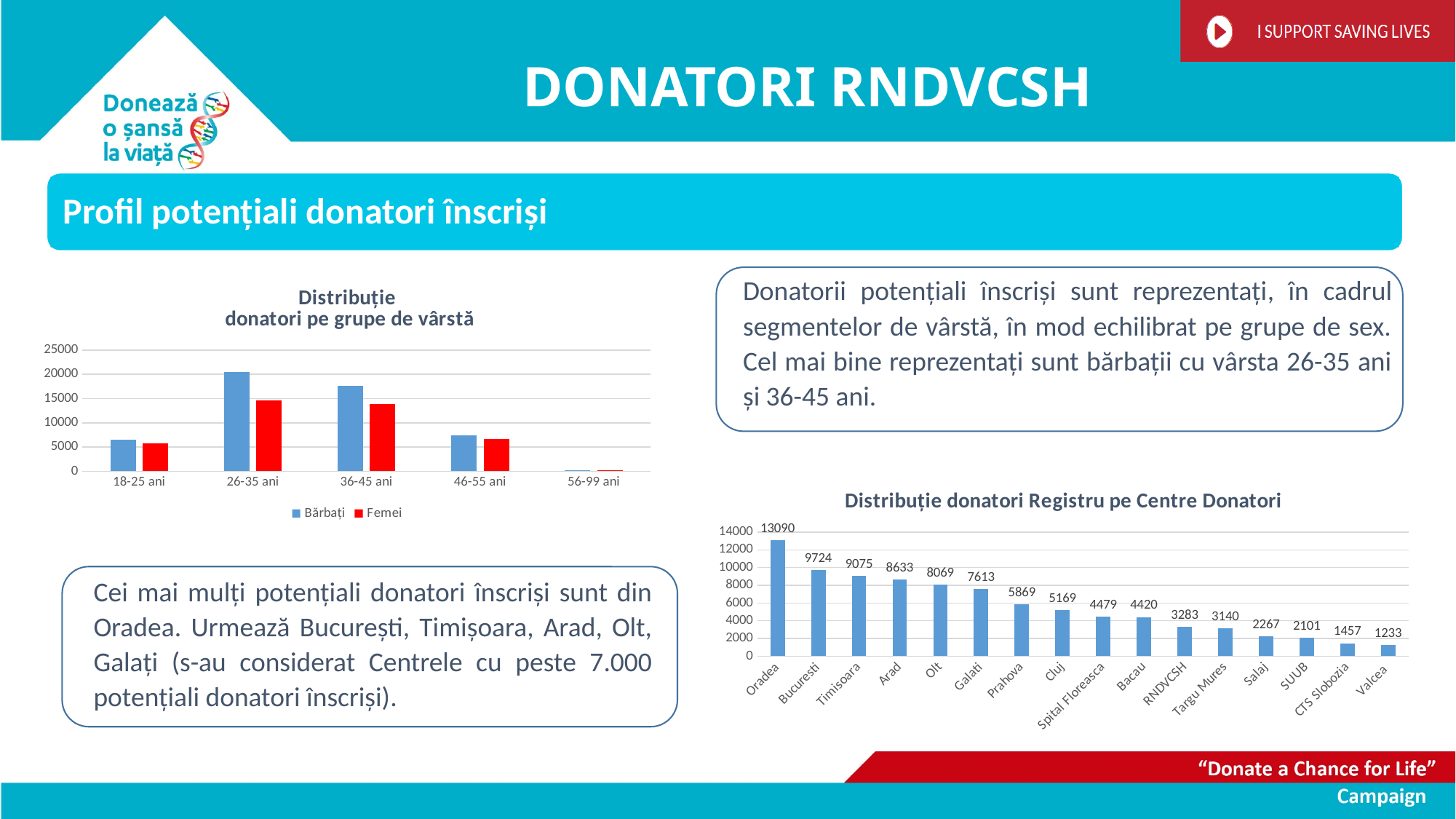
In the chart 'Distribuție donatori Registru pe Centre Donatori', what is the value for Spital Floreasca? 4479 In the chart 'Distribuție donatori Registru pe Centre Donatori', what is the value for Oradea? 13090 How many centres are shown in the chart 'Distribuție donatori Registru pe Centre Donatori'? 16 What type of chart is 'Distribuție donatori pe grupe de vârstă'? bar chart In the chart 'Distribuție donatori pe grupe de vârstă', which age group has the highest value for Bărbați? 26-35 ani In the chart 'Distribuție donatori Registru pe Centre Donatori', which centre has the lowest value? Valcea In the chart 'Distribuție donatori Registru pe Centre Donatori', which is larger, Prahova or Cluj? Prahova In the chart 'Distribuție donatori pe grupe de vârstă', is the value for Bărbați in the 26-35 ani group greater or less than 20000? greater In the chart 'Distribuție donatori Registru pe Centre Donatori', what is the difference between Bucuresti and Timisoara? 649 How many series does the legend list in the chart 'Distribuție donatori pe grupe de vârstă'? 2 In the chart 'Distribuție donatori Registru pe Centre Donatori', do the values rise or fall from left to right? fall In the chart 'Distribuție donatori pe grupe de vârstă', which is larger for the 36-45 ani group, Bărbați or Femei? Bărbați